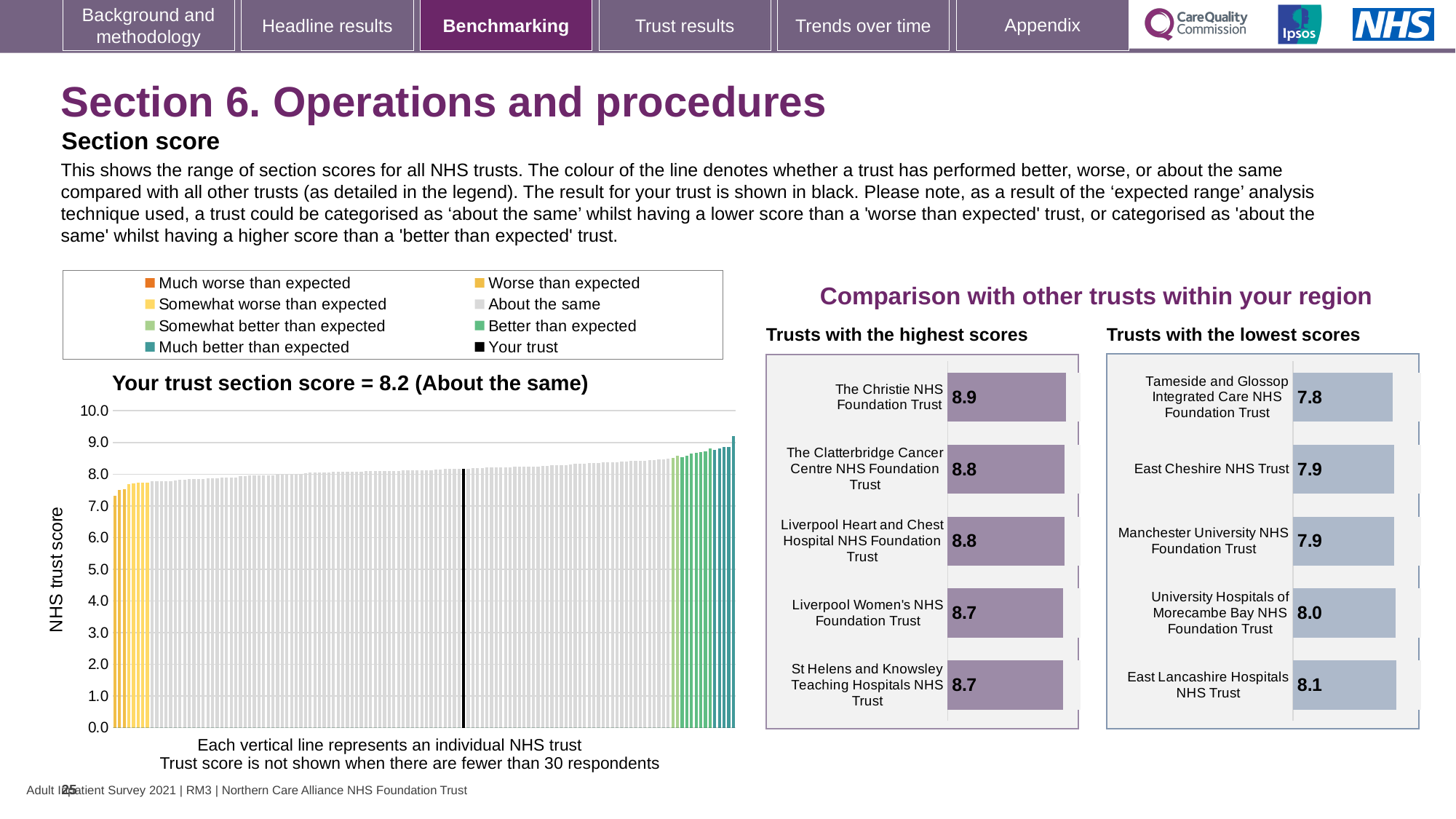
How many entries does the legend above the 'Your trust section score' chart list? 8 In the 'Trusts with the highest scores' chart, what is the difference between the scores of The Christie NHS Foundation Trust and Liverpool Women's NHS Foundation Trust? 0.2 In the 'Trusts with the lowest scores' chart, which trust has the lowest score? Tameside and Glossop Integrated Care NHS Foundation Trust In the 'Trusts with the highest scores' chart, what is the score for The Christie NHS Foundation Trust? 8.9 In the 'Trusts with the highest scores' chart, which trust has the highest score? The Christie NHS Foundation Trust What kind of chart is the 'Your trust section score' chart on the left of the slide? bar chart In the 'Your trust section score' chart, is the value of the leftmost bar greater or less than 8.0? less In the 'Trusts with the lowest scores' chart, which has the larger score: East Lancashire Hospitals NHS Trust or East Cheshire NHS Trust? East Lancashire Hospitals NHS Trust In the 'Your trust section score' chart, what is the label on the vertical axis? NHS trust score In the 'Trusts with the highest scores' chart, how many trusts are shown? 5 In the 'Your trust section score' chart, what is the section score for your trust? 8.2 In the 'Your trust section score' chart, do the bars rise or fall from left to right? rise